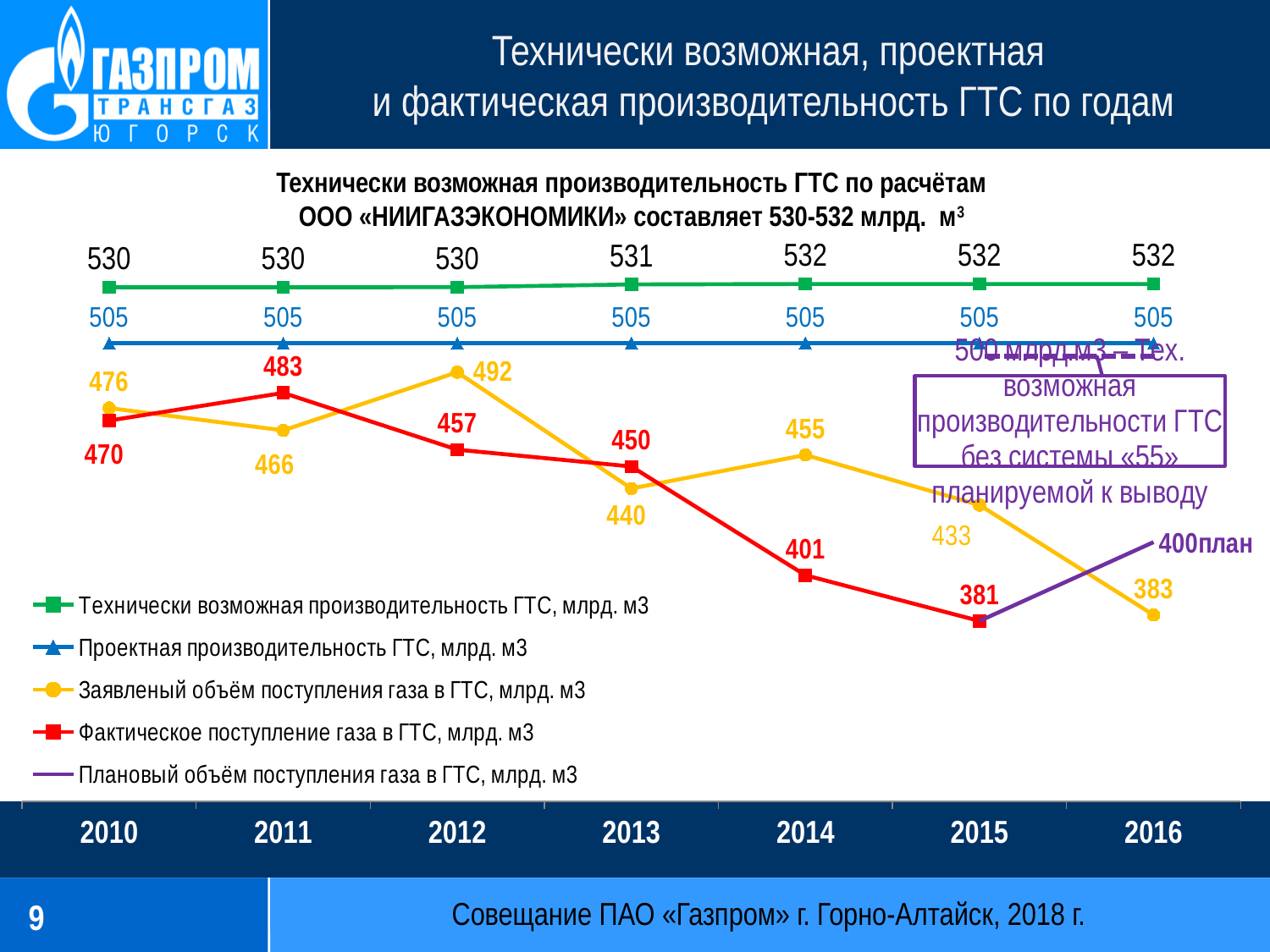
In which year is Заявленый объём поступления газа в ГТС highest? 2012 What is the value of Технически возможная производительность ГТС in 2013? 531 In which year is Фактическое поступление газа в ГТС lowest? 2015 What is the value of Фактическое поступление газа в ГТС in 2014? 401 What is the value of Заявленый объём поступления газа в ГТС in 2012? 492 How many series does the chart legend list? 5 What is the difference between Фактическое поступление газа в ГТС and Заявленый объём поступления газа в ГТС in 2011? 17 What is the difference between Технически возможная производительность ГТС and Проектная производительность ГТС in 2016? 27 How many years are shown on the x axis of the chart? 7 In 2013, which is larger: Заявленый объём поступления газа в ГТС or Фактическое поступление газа в ГТС? Фактическое поступление газа в ГТС Does Фактическое поступление газа в ГТС rise or fall from 2011 to 2015? fall What kind of chart is shown on the slide? line chart